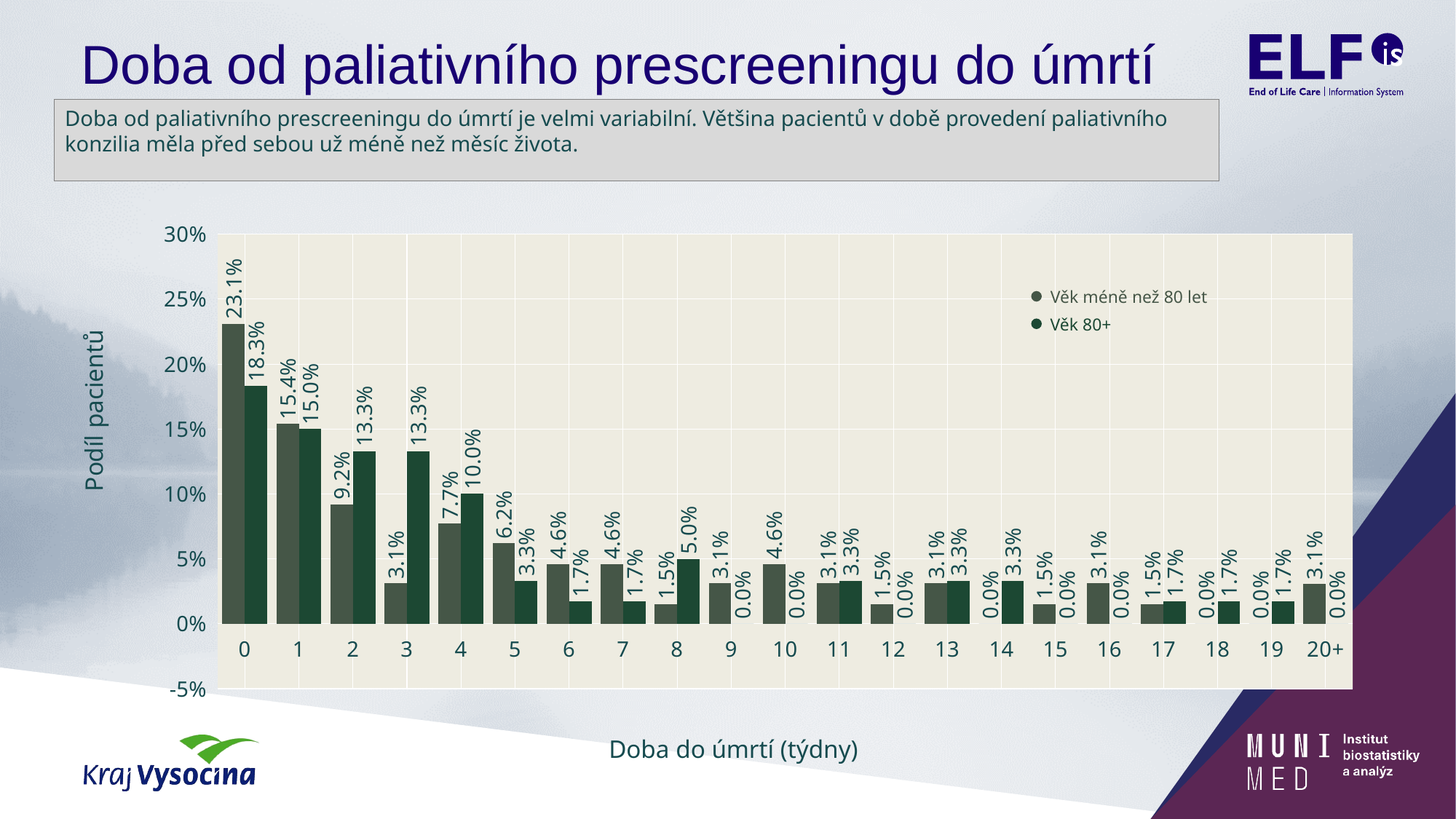
What is the difference between the 'Věk méně než 80 let' and 'Věk 80+' values at week 0? 4.8% What is the value for 'Věk 80+' at week 3? 13.3% What is the label of the x axis? Doba do úmrtí (týdny) What kind of chart is shown on the slide? bar chart What is the value for 'Věk méně než 80 let' at week 20+? 3.1% How many series does the legend list? 2 Is the value for 'Věk méně než 80 let' at week 1 greater or less than 10%? greater What is the value for 'Věk méně než 80 let' at week 0? 23.1% Which week has the highest value for 'Věk 80+'? 0 What is the value for 'Věk 80+' at week 8? 5.0% How many categories are shown on the x axis? 21 At week 2, which series has the larger value: 'Věk méně než 80 let' or 'Věk 80+'? Věk 80+